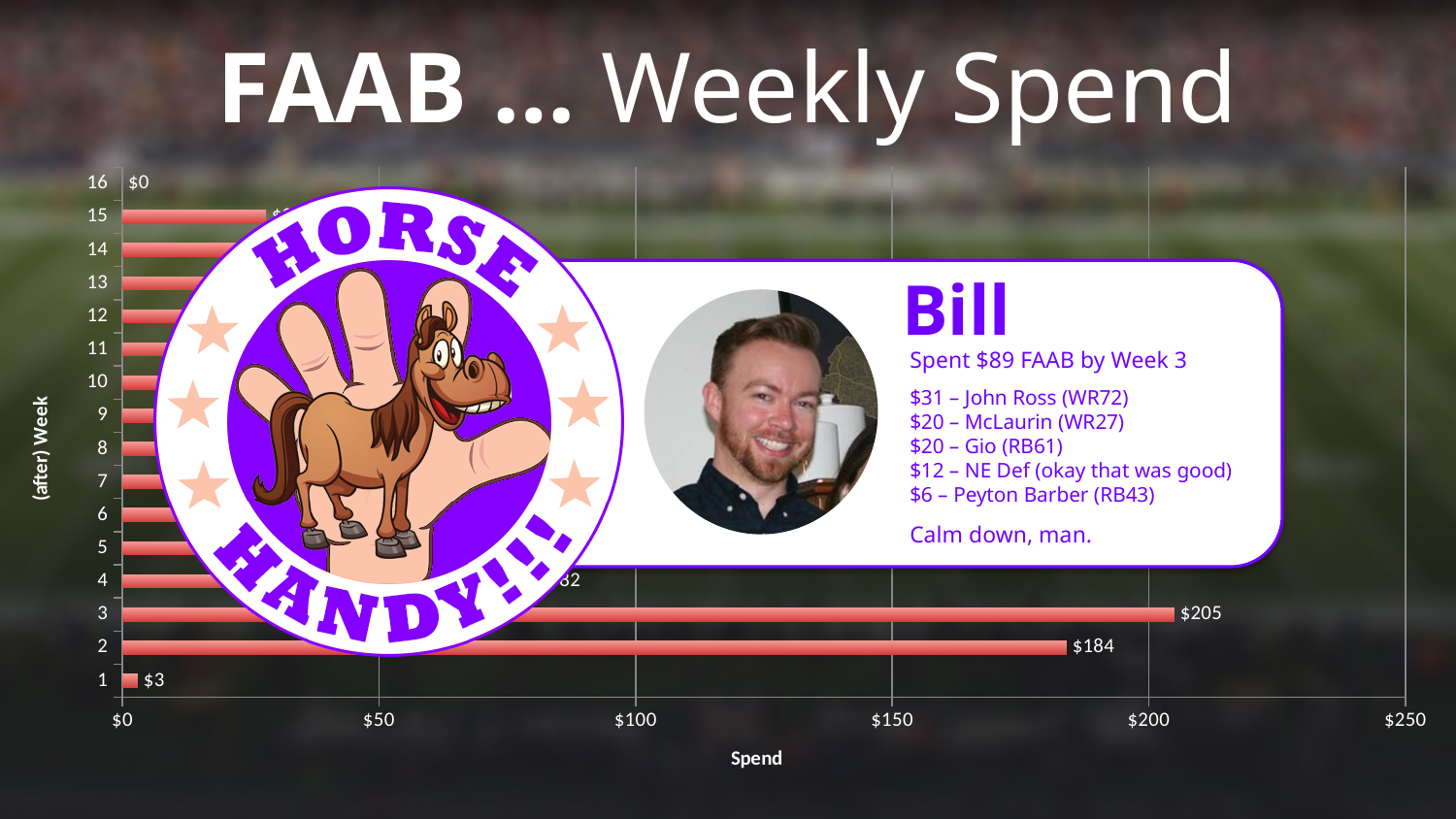
What is the difference in spend between week 3 and week 2? $21 Which week has the highest spend? Week 3 What is the spend value for week 2? $184 What is the title of the horizontal axis of the chart? Spend Is the spend for week 2 greater or less than $200? less How many weeks are listed on the vertical axis of the chart? 16 Is the spend for week 3 greater or less than $200? greater Which week has the larger spend, week 2 or week 3? Week 3 What is the spend value for week 1? $3 What kind of chart is shown on the slide? bar chart What is the spend value for week 3? $205 What is the spend value for week 16? $0